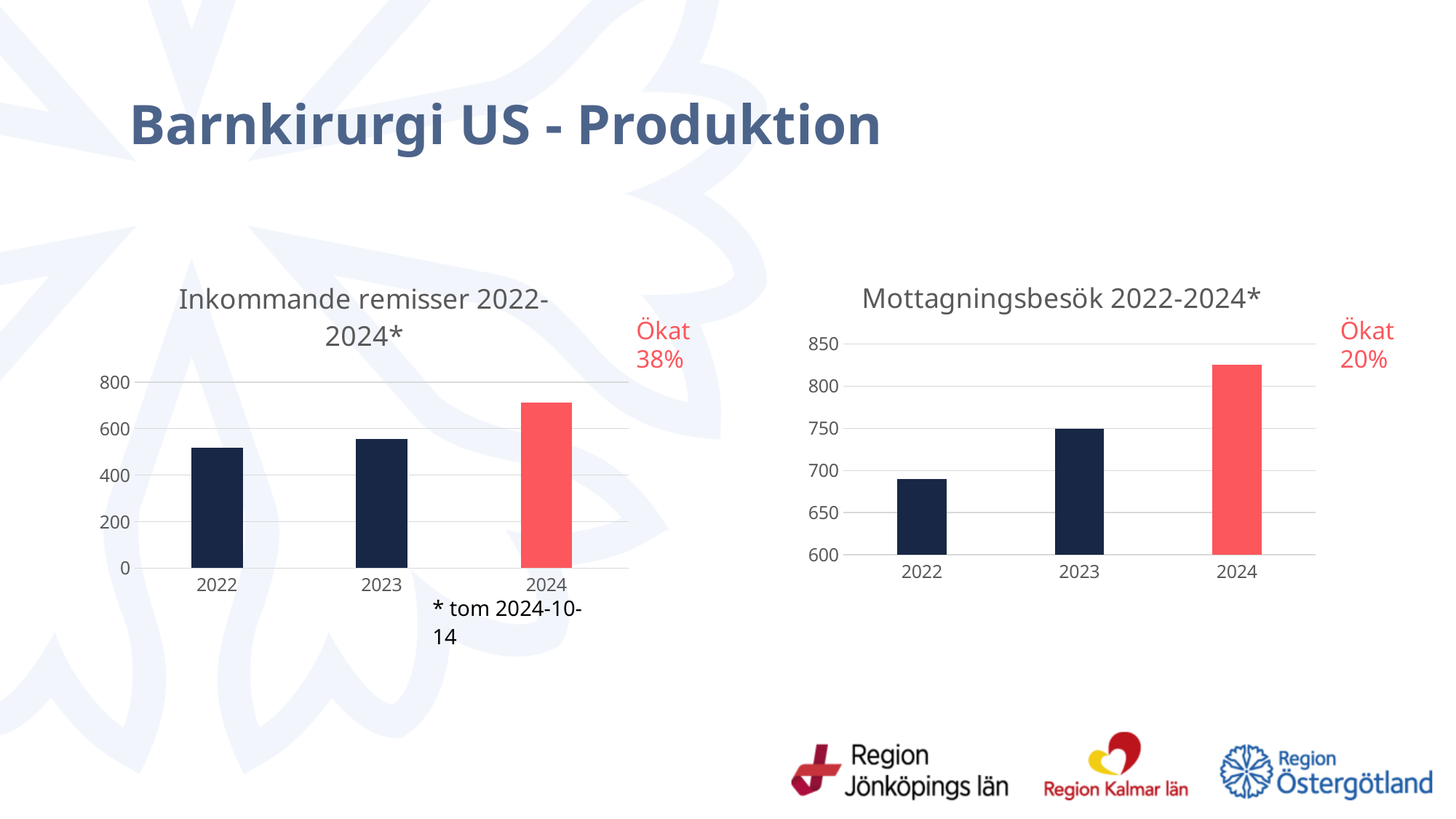
In the 'Mottagningsbesök 2022-2024*' chart, which is larger, the value for 2023 or the value for 2024? 2024 In the 'Inkommande remisser 2022-2024*' chart, which year has the highest value? 2024 What is the title of the chart on the right side of the slide? Mottagningsbesök 2022-2024* What percentage increase is annotated next to the 'Inkommande remisser 2022-2024*' chart? Ökat 38% In the 'Inkommande remisser 2022-2024*' chart, is the value for 2024 greater or less than 600? greater In the 'Inkommande remisser 2022-2024*' chart, do the values rise or fall from 2022 to 2024? rise In the 'Mottagningsbesök 2022-2024*' chart, is the value for 2024 greater or less than 800? greater What kind of chart is the 'Inkommande remisser 2022-2024*' chart? bar chart In the 'Inkommande remisser 2022-2024*' chart, is the value for 2022 greater or less than 600? less In the 'Mottagningsbesök 2022-2024*' chart, which year has the lowest value? 2022 How many years are shown on the 'Mottagningsbesök 2022-2024*' chart? 3